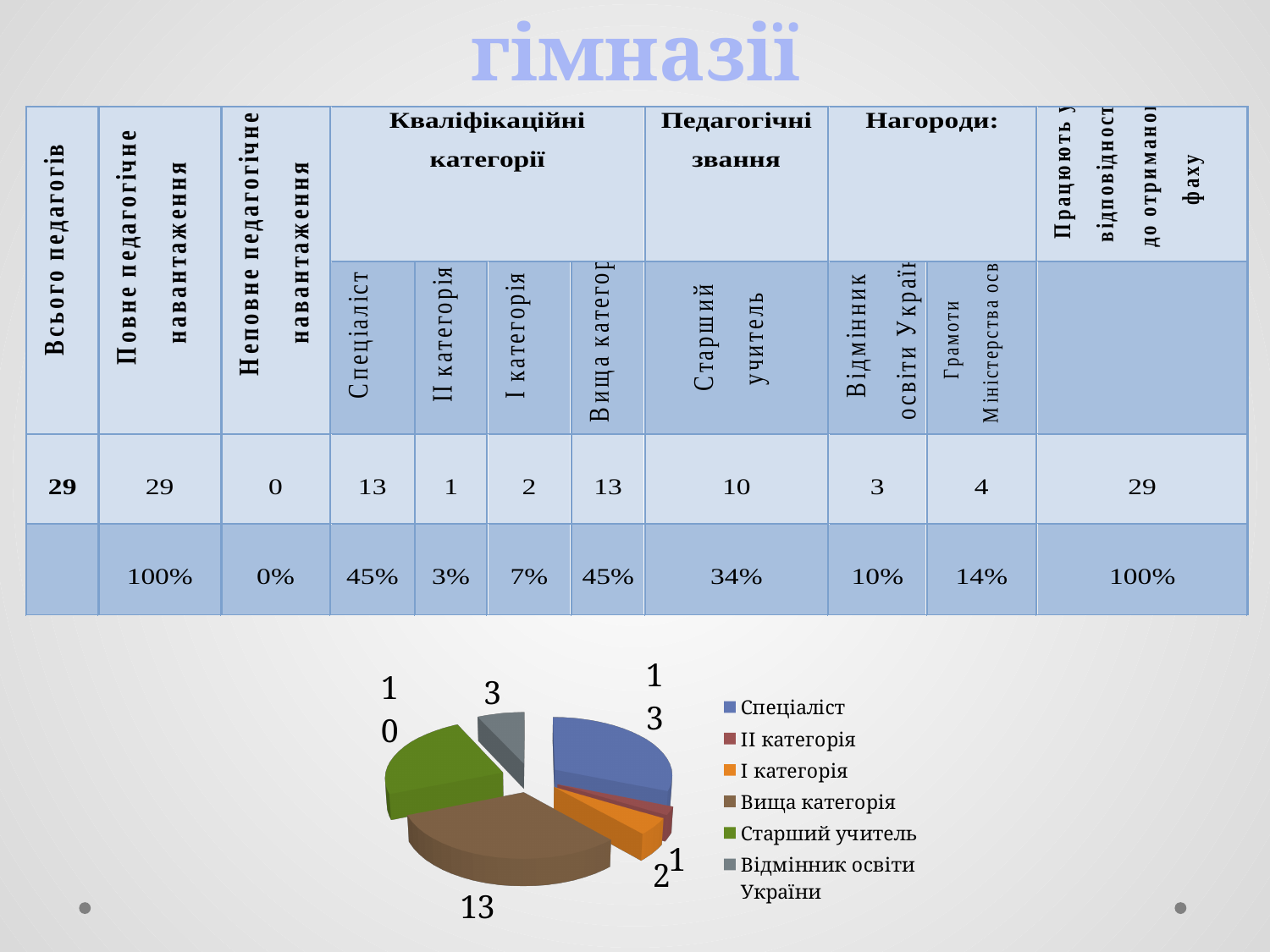
Which colour represents Вища категорія in the pie chart legend? brown How many slices does the pie chart have? 6 What is the value of the І категорія slice in the pie chart? 2 What is the value of the Старший учитель slice in the pie chart? 10 How many entries does the legend of the pie chart list? 6 In the pie chart, what is the difference between the Вища категорія value and the Старший учитель value? 3 In the pie chart, what is the difference between the Старший учитель value and the Відмінник освіти України value? 7 What is the value of the Спеціаліст slice in the pie chart? 13 What kind of chart is shown at the bottom of the slide? pie chart Which slice of the pie chart has the smallest value? ІІ категорія What is the value of the Відмінник освіти України slice in the pie chart? 3 In the pie chart, which is larger: Старший учитель or Відмінник освіти України? Старший учитель